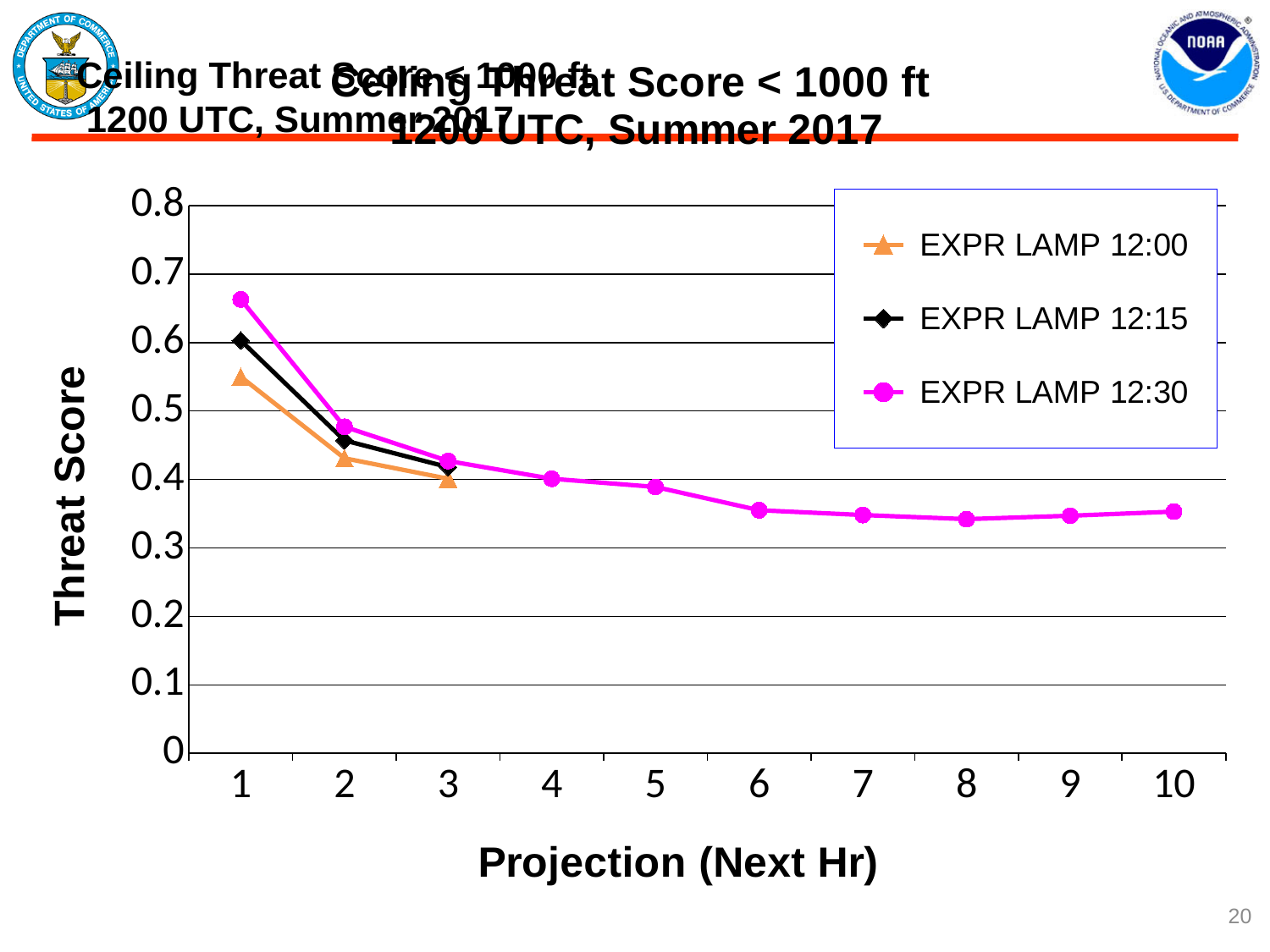
At which projection hour does the EXPR LAMP 12:30 series reach its highest threat score? 1 What is the label of the x axis? Projection (Next Hr) Is the EXPR LAMP 12:30 threat score at projection 1 greater or less than 0.6? greater Is the EXPR LAMP 12:30 threat score at projection 2 greater or less than 0.5? less What kind of chart is shown on the slide? Line chart Is the EXPR LAMP 12:00 threat score at projection 1 greater or less than 0.6? less How many projection hours are plotted for the EXPR LAMP 12:30 series? 10 How many series does the legend list? 3 Does the EXPR LAMP 12:30 threat score generally rise or fall as the projection hour increases from 1 to 8? Fall At projection 1, which series has the higher threat score, EXPR LAMP 12:30 or EXPR LAMP 12:00? EXPR LAMP 12:30 How many projection hours are plotted for the EXPR LAMP 12:00 series? 3